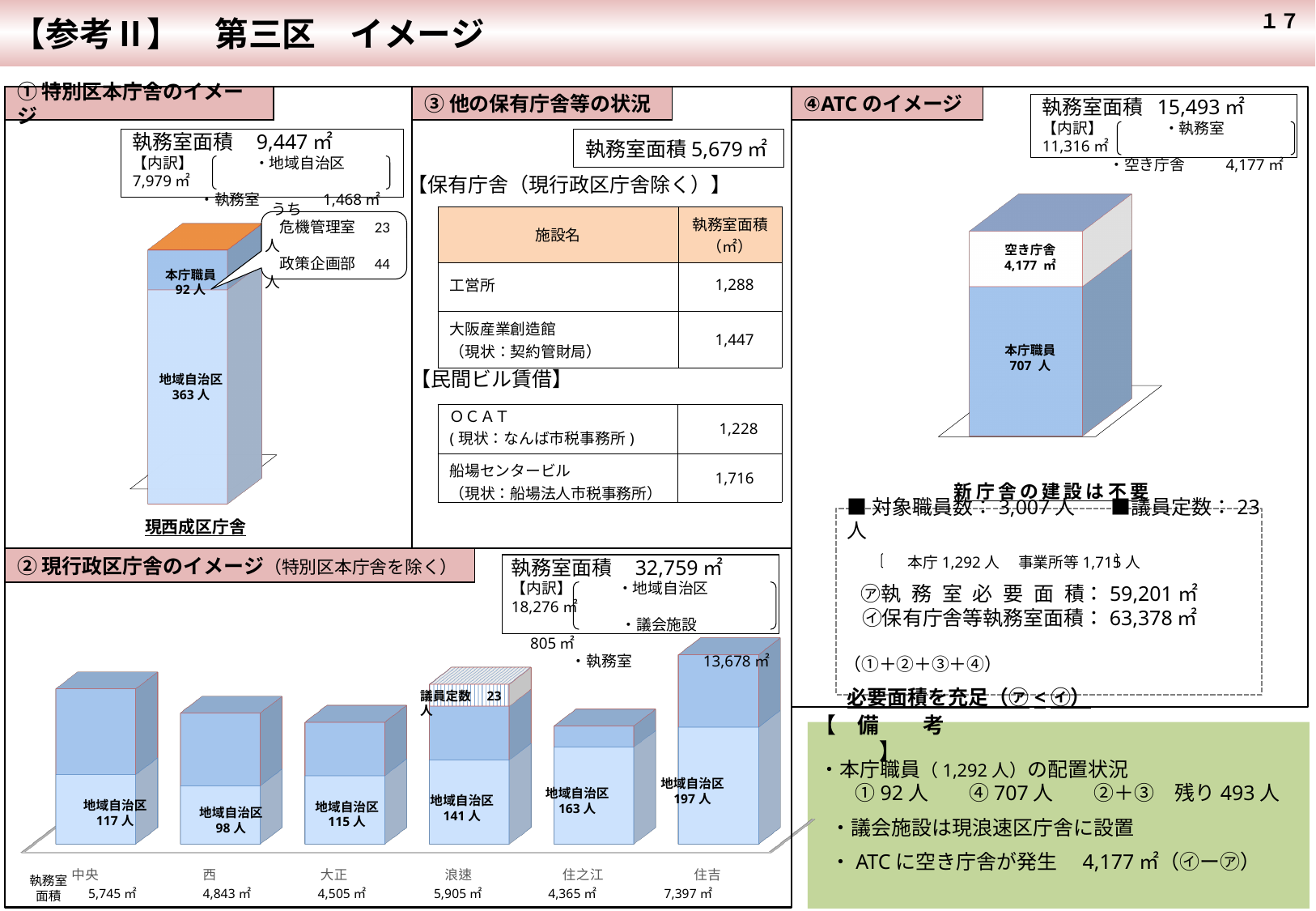
In the ④ ATC のイメージ diagram, what is the area of the 空き庁舎 block? 4,177 ㎡ In the ② 現行政区庁舎のイメージ diagram, which ward has the smallest 執務室面積? 住之江 In the ② 現行政区庁舎のイメージ diagram, which has more 地域自治区 staff, 浪速 or 大正? 浪速 In the ① 特別区本庁舎のイメージ diagram, how many 本庁職員 are shown? 92 人 In the ② 現行政区庁舎のイメージ diagram, how many 地域自治区 staff are shown for 住吉? 197 人 In the ② 現行政区庁舎のイメージ diagram, how many wards are shown? 6 In the ② 現行政区庁舎のイメージ diagram, which ward has the fewest 地域自治区 staff? 西 In the ① 特別区本庁舎のイメージ diagram, what is the total number of staff shown in the stacked block (本庁職員 plus 地域自治区)? 455 人 In the ② 現行政区庁舎のイメージ diagram, which ward has the largest 執務室面積? 住吉 In the ② 現行政区庁舎のイメージ diagram, what is the 執務室面積 for 中央? 5,745 ㎡ In the ② 現行政区庁舎のイメージ diagram, what is the difference in 執務室面積 between 住吉 and 住之江? 3,032 ㎡ In the ② 現行政区庁舎のイメージ diagram, which ward's block includes the 議員定数 23 人 section? 浪速